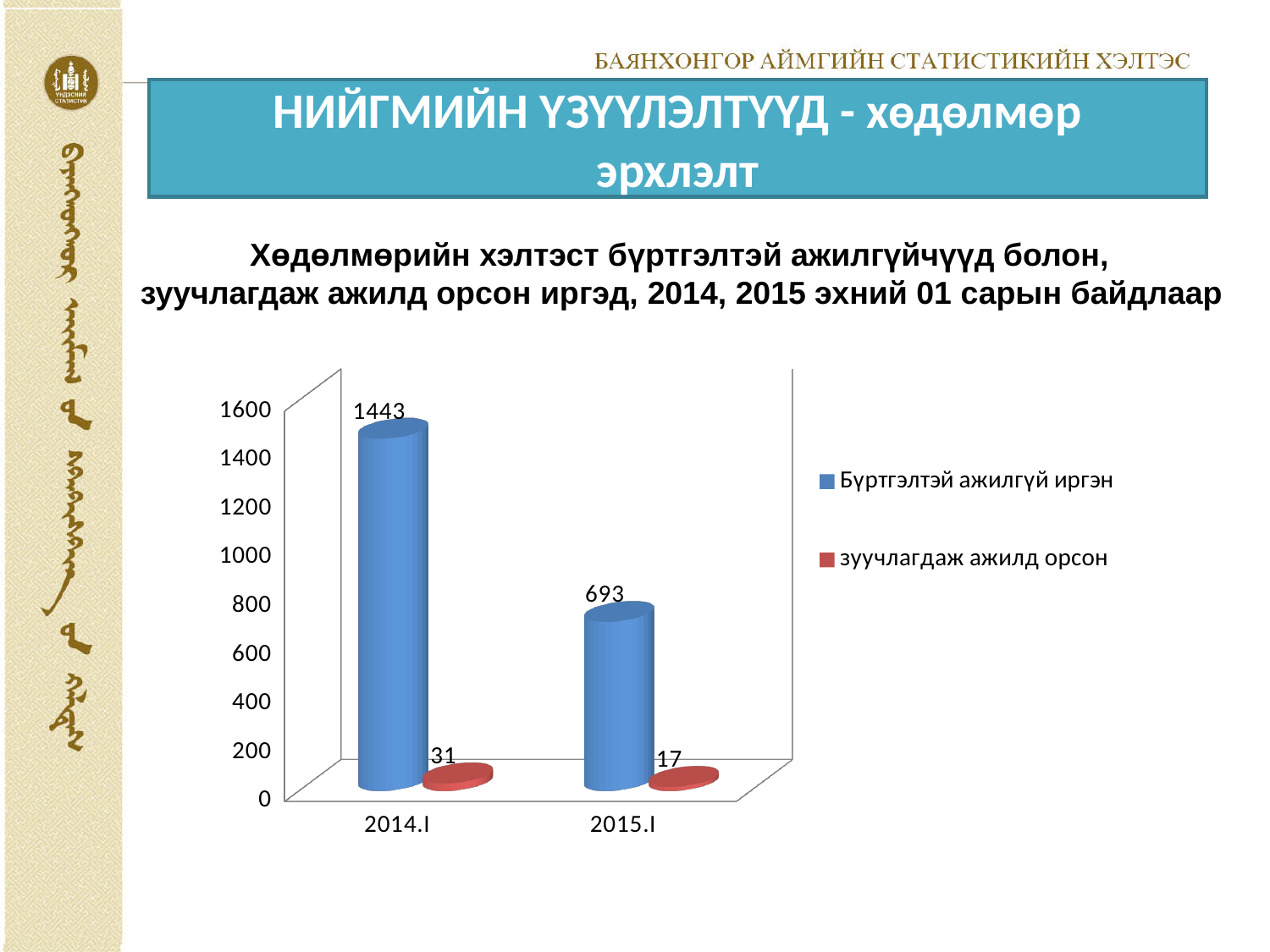
What kind of chart is shown on the slide? bar chart What is the value for Бүртгэлтэй ажилгүй иргэн in 2014.I? 1443 Which period has the higher value for Бүртгэлтэй ажилгүй иргэн? 2014.I What is the difference between the Бүртгэлтэй ажилгүй иргэн values for 2014.I and 2015.I? 750 Is the value for Бүртгэлтэй ажилгүй иргэн in 2015.I greater or less than 800? less What is the value for зуучлагдаж ажилд орсон in 2014.I? 31 How many series does the legend list? 2 What is the value for зуучлагдаж ажилд орсон in 2015.I? 17 What is the difference between the зуучлагдаж ажилд орсон values for 2014.I and 2015.I? 14 How many periods are shown on the x axis? 2 Which period has the lower value for зуучлагдаж ажилд орсон? 2015.I What is the value for Бүртгэлтэй ажилгүй иргэн in 2015.I? 693